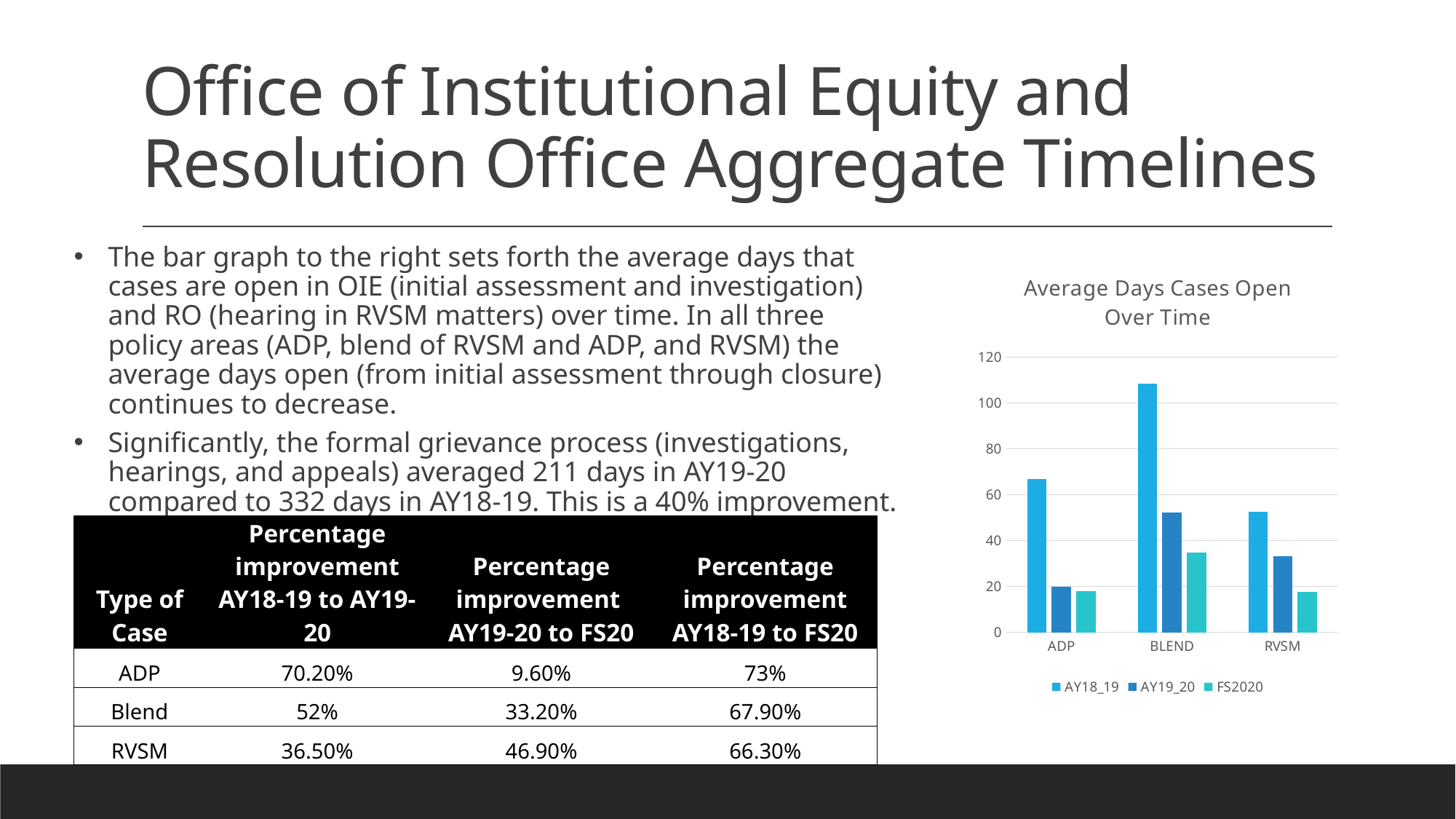
Which is larger: the AY19_20 value for BLEND or the AY19_20 value for RVSM? BLEND Is the AY19_20 value for ADP greater or less than 40? less Which category has the lowest AY18_19 bar? RVSM Which category has the highest AY18_19 bar? BLEND How many categories are shown on the x axis of the chart? 3 Which is larger: the AY18_19 value for ADP or the AY18_19 value for RVSM? ADP Is the AY18_19 value for BLEND greater or less than 100? greater How many series does the chart legend list? 3 Is the AY18_19 value for ADP greater or less than 60? greater What is the title of the chart? Average Days Cases Open Over Time For the BLEND category, do the values rise or fall from AY18_19 to FS2020? fall What kind of chart is shown on the slide? Bar chart